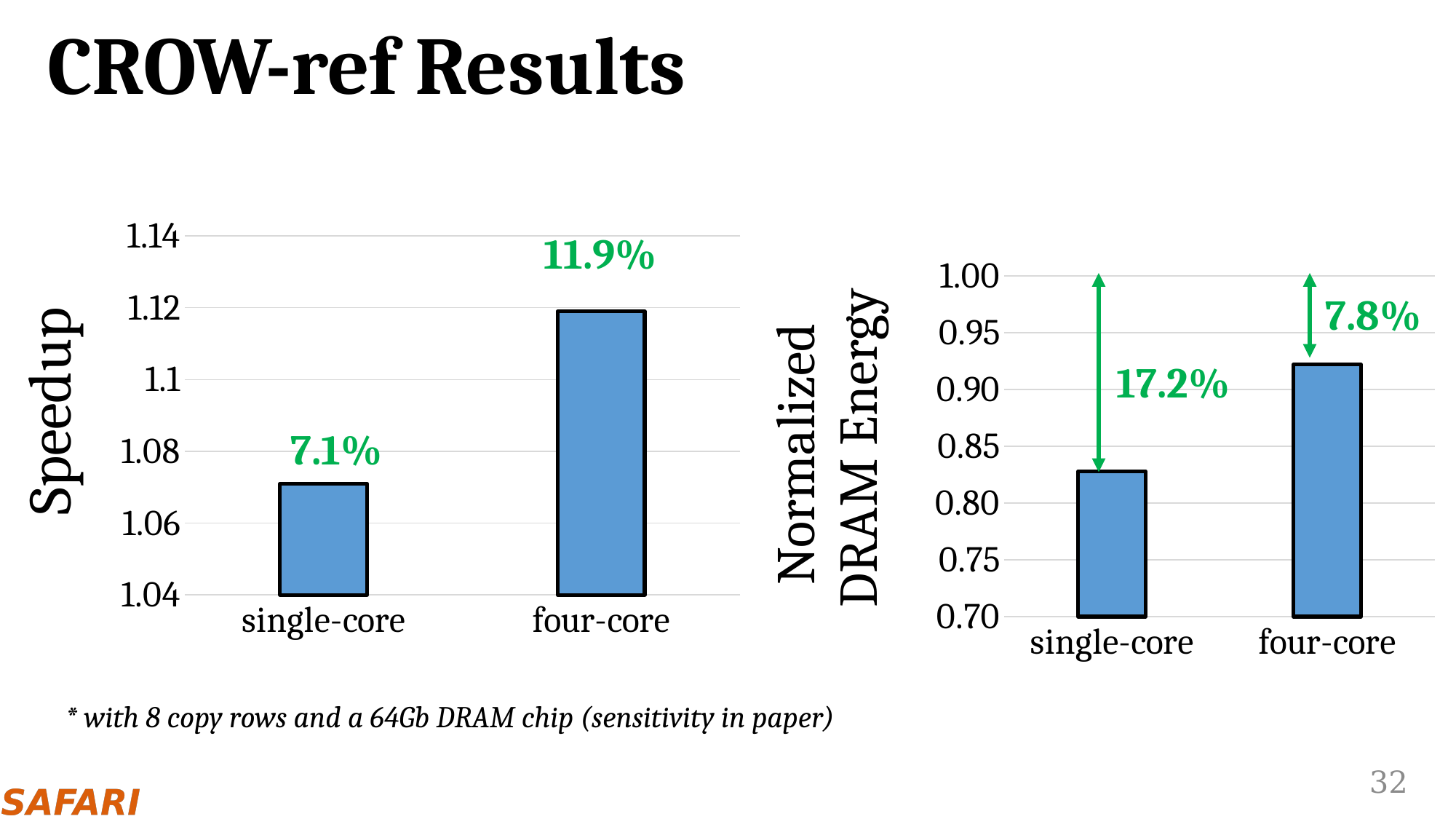
In the Speedup chart, which category has the higher speedup? four-core In the Normalized DRAM Energy chart, what percentage reduction is annotated for four-core? 7.8% How many categories are shown in the Speedup chart? 2 In the Speedup chart, is the value for single-core greater or less than 1.08? less In the Speedup chart, what percentage label is shown above the single-core bar? 7.1% In the Normalized DRAM Energy chart, is the value for four-core greater or less than 0.90? greater In the Normalized DRAM Energy chart, which category has the lower normalized DRAM energy? single-core In the Normalized DRAM Energy chart, is the value for single-core greater or less than 0.85? less What kind of chart is the Normalized DRAM Energy chart? bar chart In the Speedup chart, what percentage label is shown above the four-core bar? 11.9% In the Normalized DRAM Energy chart, what percentage reduction is annotated for single-core? 17.2%